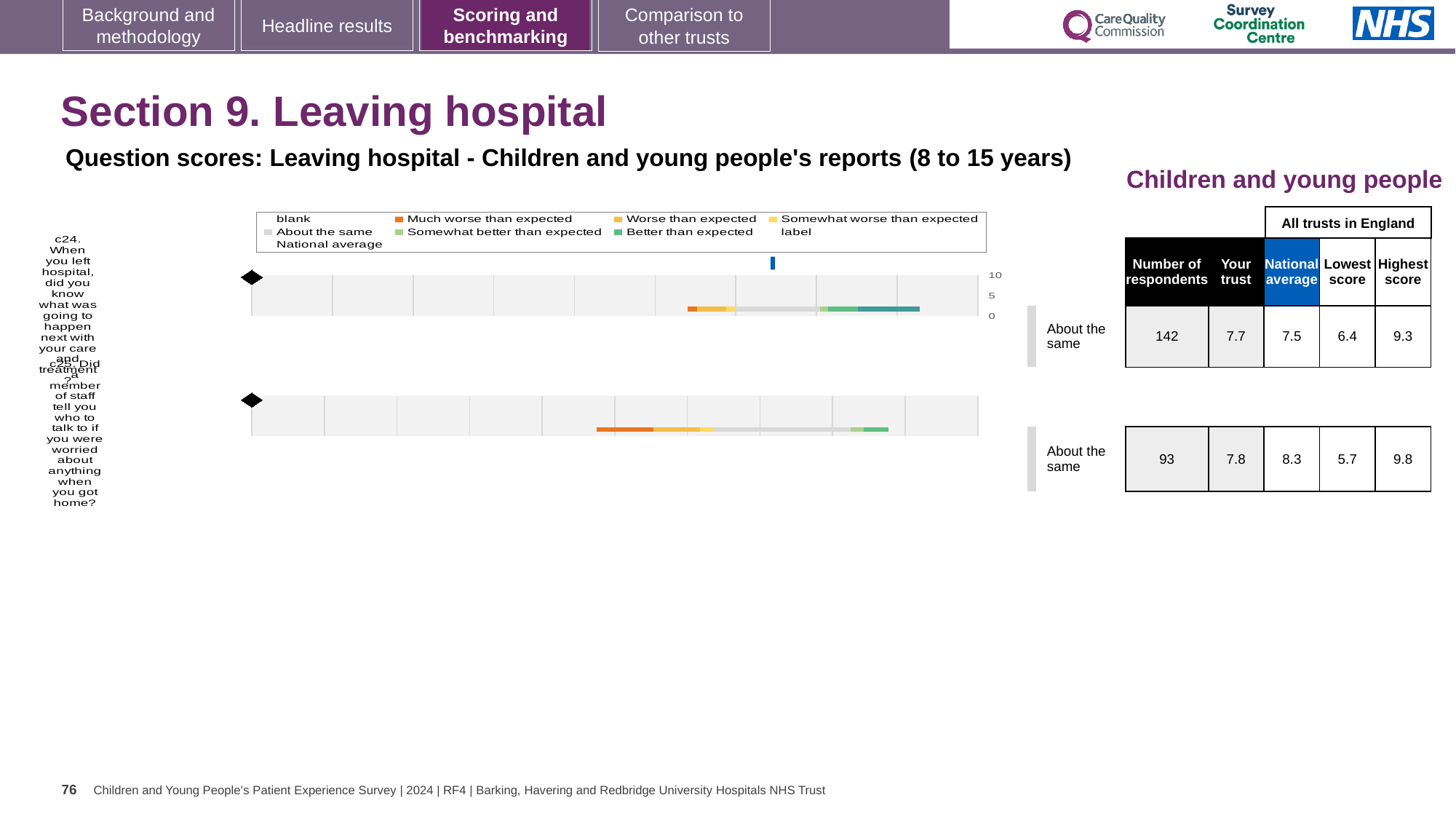
How many questions are plotted on the slide? 2 What is the difference between the highest score and the lowest score for question c24? 2.9 What benchmarking category is the trust given for question c24? About the same Which question has the higher 'Your trust' score, c24 or c25? c25 For question c25, which is higher: the 'Your trust' score or the national average? National average How many respondents answered question c24? 142 What kind of chart is used to show the question scores for c24 and c25? Bar chart What is the difference between the highest score and the lowest score for question c25? 4.1 What is the lowest score among all trusts in England for question c25? 5.7 For question c24, which is higher: the 'Your trust' score or the national average? Your trust What is the national average score for question c25 (Did a member of staff tell you who to talk to if you were worried about anything when you got home?)? 8.3 What is the 'Your trust' score for question c24 (When you left hospital, did you know what was going to happen next with your care and treatment?)? 7.7